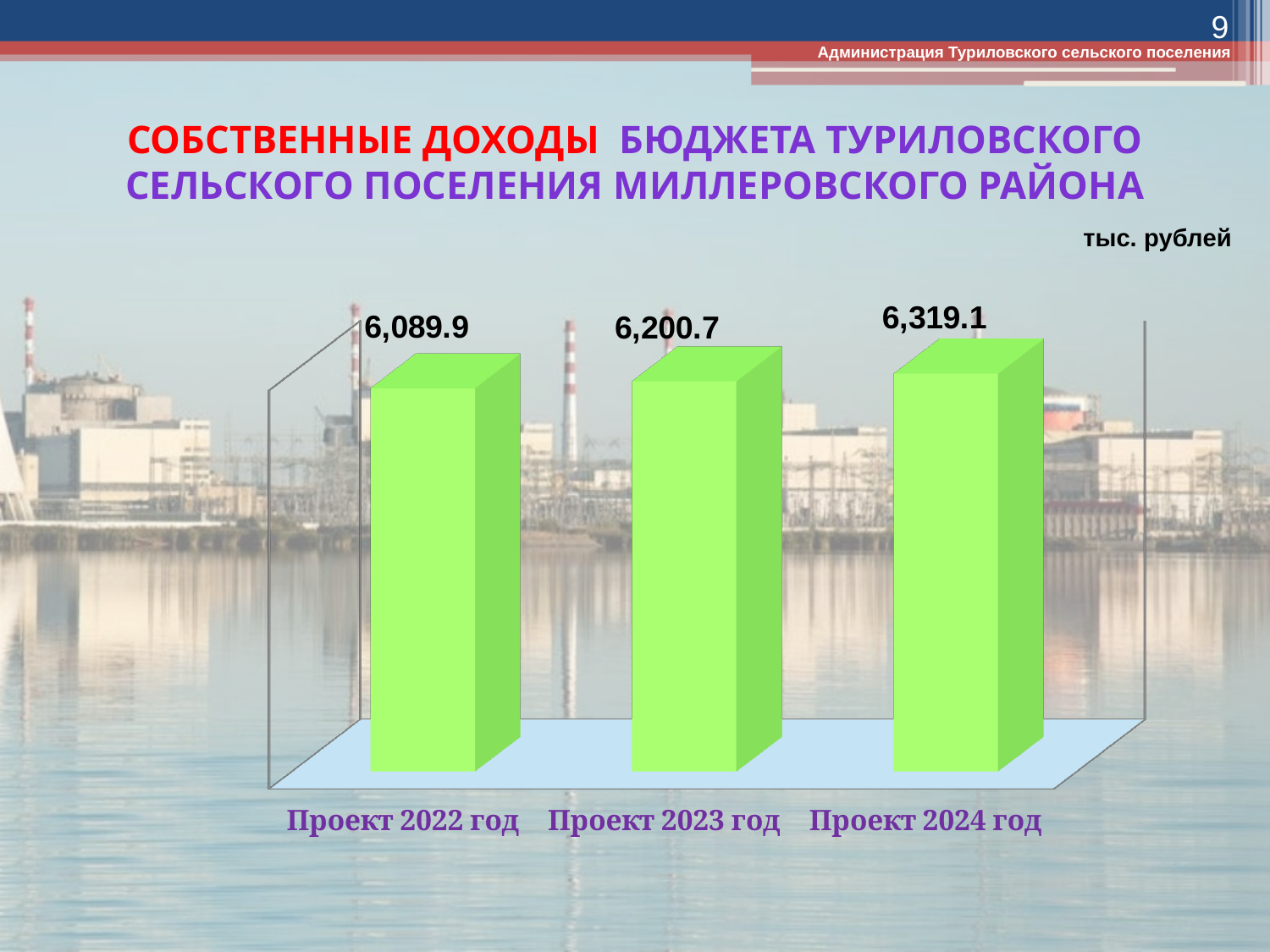
What kind of chart is shown on the slide? Bar chart What is the value for Проект 2024 год? 6,319.1 Do the values rise or fall from Проект 2022 год to Проект 2024 год? Rise Which is larger, the value for Проект 2022 год or Проект 2024 год? Проект 2024 год What is the value for Проект 2023 год? 6,200.7 Which category has the lowest value? Проект 2022 год What is the difference between the values for Проект 2024 год and Проект 2022 год? 229.2 What is the difference between the values for Проект 2024 год and Проект 2023 год? 118.4 How many categories are shown in the chart? 3 What is the value for Проект 2022 год? 6,089.9 Which category has the highest value? Проект 2024 год What is the difference between the values for Проект 2023 год and Проект 2022 год? 110.8